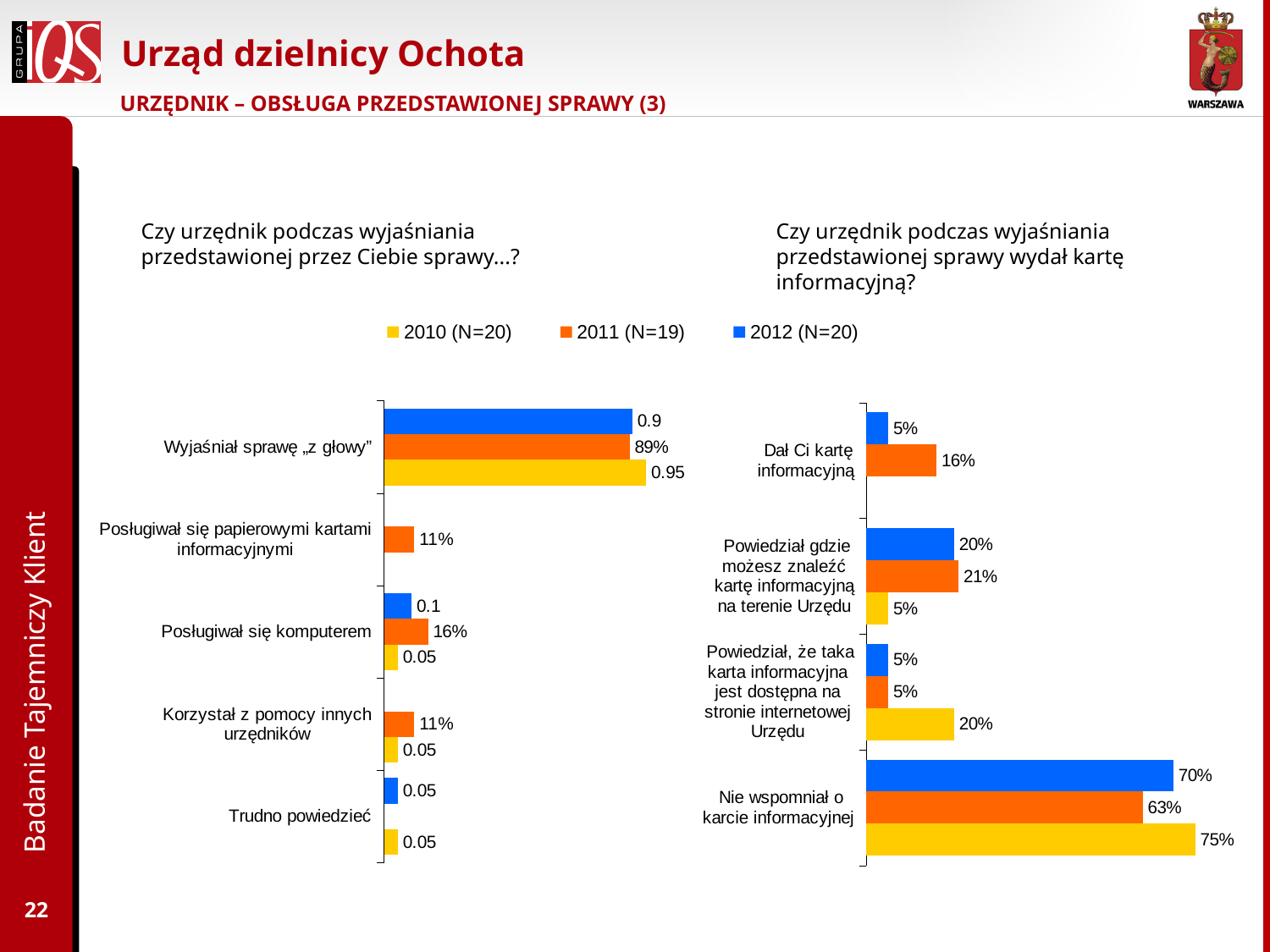
In the left chart, how many categories are listed on the vertical axis? 5 In the right chart, which is larger for "Dał Ci kartę informacyjną": the 2011 (N=19) value or the 2012 (N=20) value? 2011 (N=19) In the left chart, which category has the highest value for 2012 (N=20)? Wyjaśniał sprawę „z głowy” What type of chart is shown on the right side of the slide? Bar chart In the left chart, what is the 2011 (N=19) value for "Posługiwał się komputerem"? 16% In the left chart, what value is printed for the 2010 (N=20) bar of "Wyjaśniał sprawę „z głowy”"? 0.95 In the left chart ("Czy urzędnik podczas wyjaśniania przedstawionej przez Ciebie sprawy...?"), what is the 2011 (N=19) value for "Wyjaśniał sprawę „z głowy”"? 89% How many series does the legend list? 3 In the right chart, what is the difference between the 2010 (N=20) and 2011 (N=19) values for "Nie wspomniał o karcie informacyjnej"? 12% In the right chart ("Czy urzędnik podczas wyjaśniania przedstawionej sprawy wydał kartę informacyjną?"), what is the 2012 (N=20) value for "Nie wspomniał o karcie informacyjnej"? 70% In the right chart, what is the 2010 (N=20) value for "Powiedział, że taka karta informacyjna jest dostępna na stronie internetowej Urzędu"? 20%